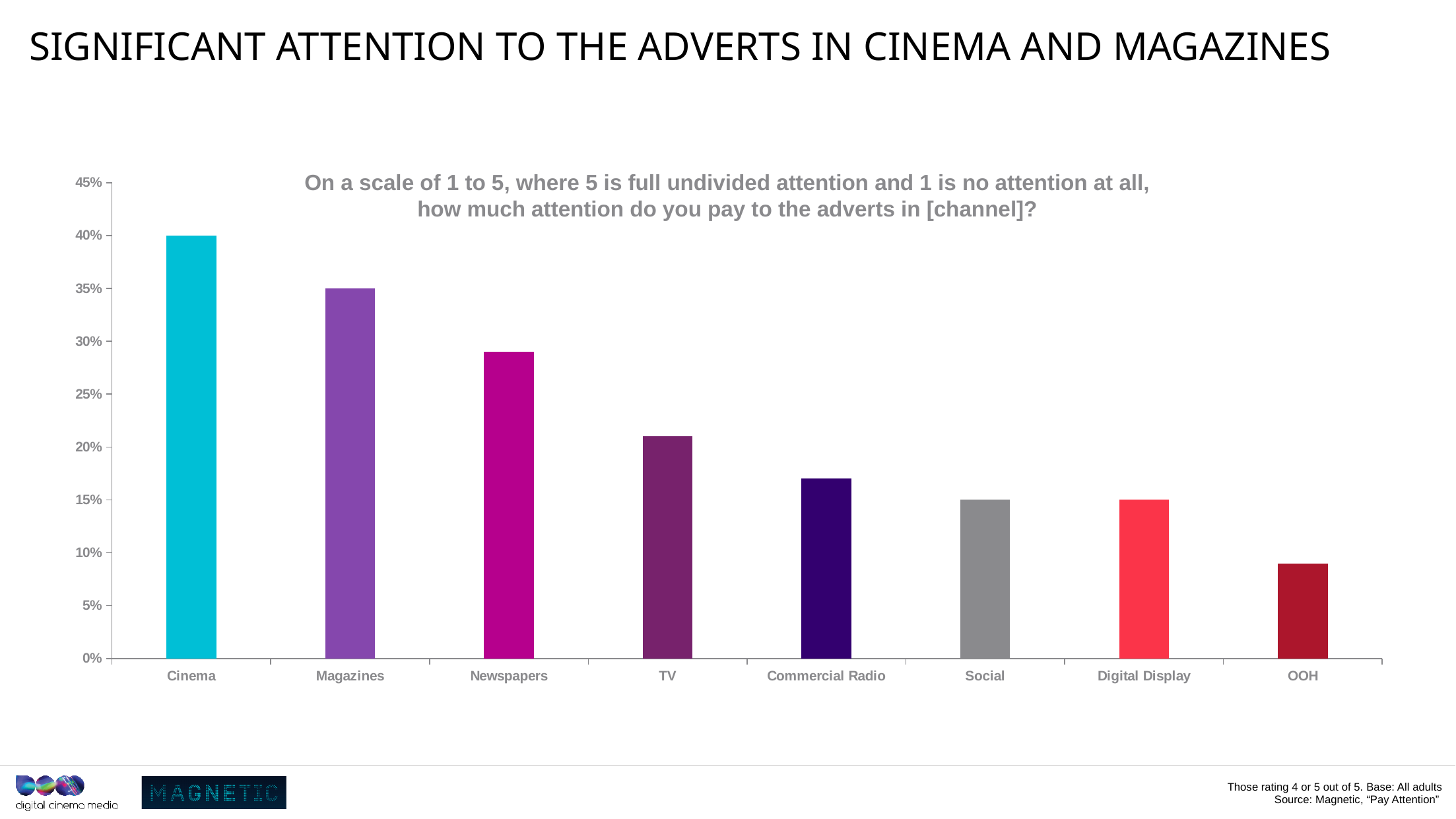
Is the value for OOH greater or less than 10%? less What is the value for Social? 15% Is the value for Newspapers greater or less than 25%? greater Which channel has the lowest share of people paying attention to its adverts? OOH What is the value for Magazines? 35% Which is larger, the value for TV or the value for Commercial Radio? TV Which channel has the highest share of people paying attention to its adverts? Cinema Do the values rise or fall moving from left to right along the x axis? fall What kind of chart is shown on the slide? bar chart How many channels are shown on the x axis of the chart? 8 What is the value for Cinema? 40% What is the difference between the values for Cinema and Magazines? 5%